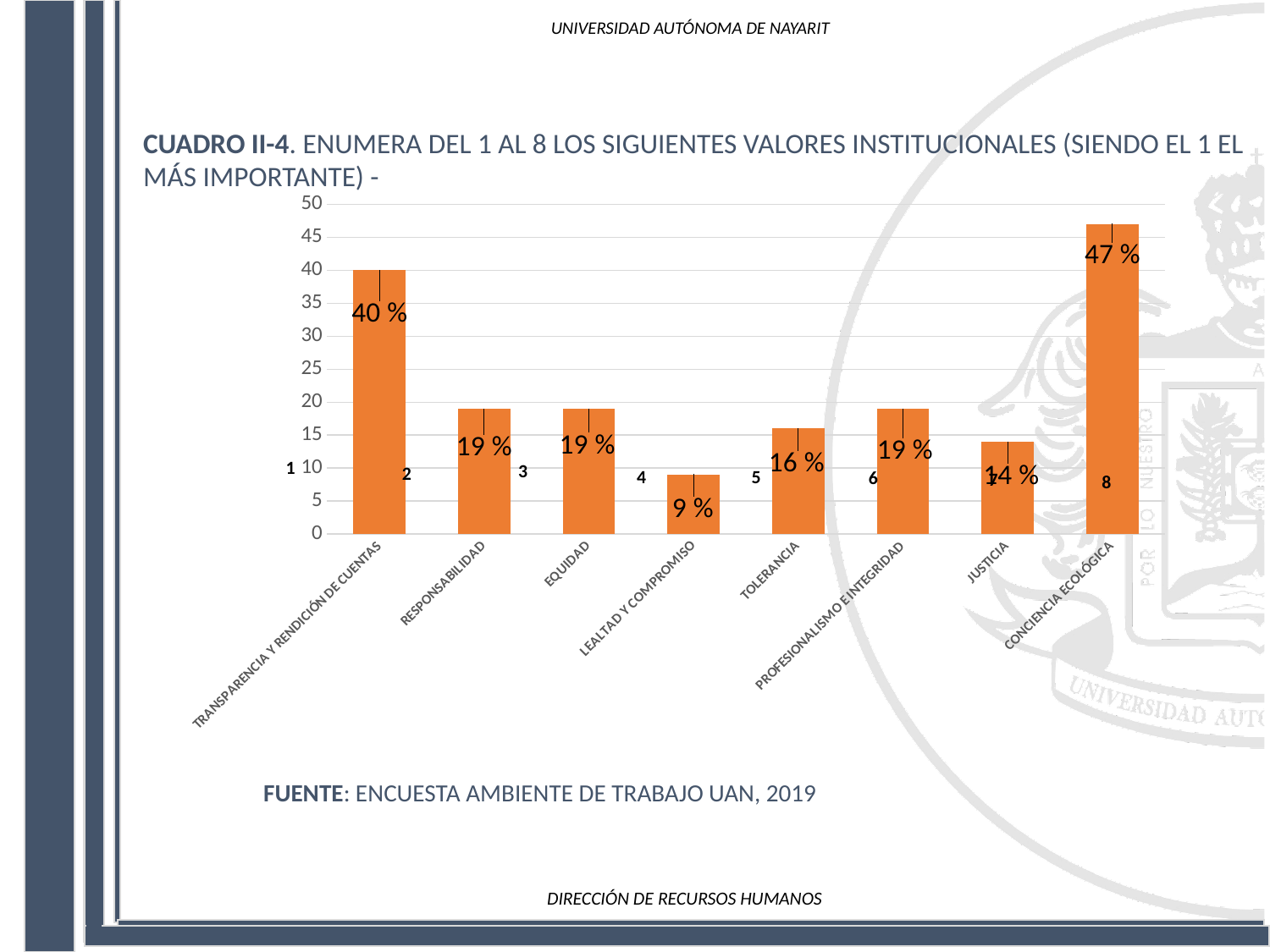
What is the difference between the values for CONCIENCIA ECOLÓGICA and TRANSPARENCIA Y RENDICIÓN DE CUENTAS? 7 % What is the value for JUSTICIA? 14 % Which category has the highest value? CONCIENCIA ECOLÓGICA How many categories are plotted in the chart? 8 What is the value for LEALTAD Y COMPROMISO? 9 % Which is larger, the value for TOLERANCIA or the value for JUSTICIA? TOLERANCIA What type of chart is shown on the slide? bar chart What source is cited below the chart? ENCUESTA AMBIENTE DE TRABAJO UAN, 2019 What is the value for TRANSPARENCIA Y RENDICIÓN DE CUENTAS? 40 % What is the value for TOLERANCIA? 16 % What is the value for CONCIENCIA ECOLÓGICA? 47 % Which category has the lowest value? LEALTAD Y COMPROMISO